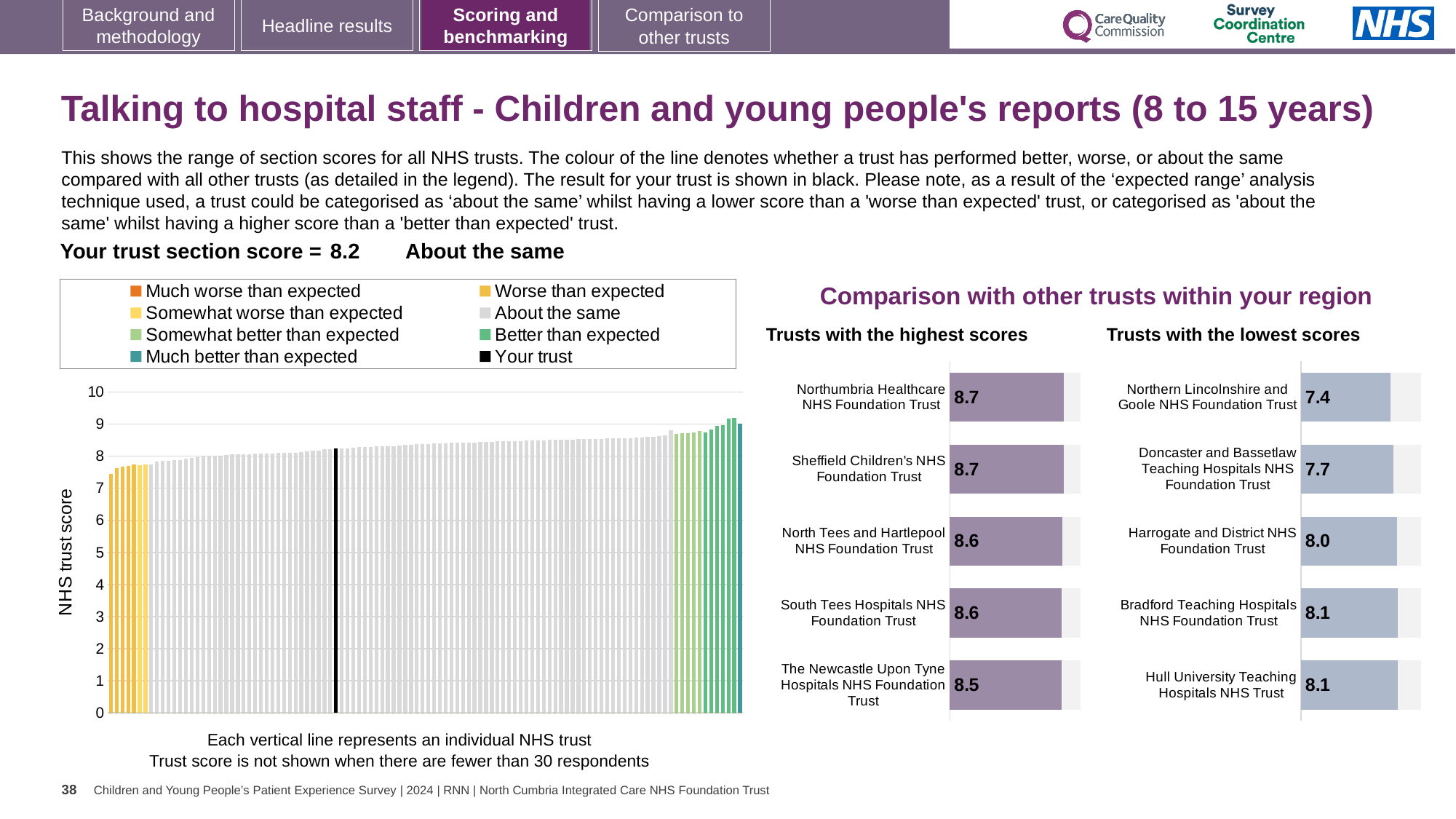
In the 'Trusts with the highest scores' chart, what is the score for North Tees and Hartlepool NHS Foundation Trust? 8.6 In the 'Trusts with the lowest scores' chart, which has the higher score: Doncaster and Bassetlaw Teaching Hospitals NHS Foundation Trust or Bradford Teaching Hospitals NHS Foundation Trust? Bradford Teaching Hospitals NHS Foundation Trust In the 'Trusts with the highest scores' chart, what is the difference between the scores of Northumbria Healthcare NHS Foundation Trust and The Newcastle Upon Tyne Hospitals NHS Foundation Trust? 0.2 In the 'Trusts with the lowest scores' chart, which trust has the lowest score? Northern Lincolnshire and Goole NHS Foundation Trust What kind of chart is the large chart on the left of the slide? Bar chart How many entries does the legend of the large chart on the left list? 8 How many trusts are listed in the 'Trusts with the highest scores' chart? 5 In the 'Trusts with the lowest scores' chart, what is the score for Doncaster and Bassetlaw Teaching Hospitals NHS Foundation Trust? 7.7 In the 'Trusts with the lowest scores' chart, what is the difference between the scores of Harrogate and District NHS Foundation Trust and Northern Lincolnshire and Goole NHS Foundation Trust? 0.6 In the large chart on the left, is the value for the lowest-scoring trust greater or less than 7? greater In the large chart on the left, is the value for the highest-scoring trust greater or less than 10? less In the 'Trusts with the highest scores' chart, which trust has the lowest score shown? The Newcastle Upon Tyne Hospitals NHS Foundation Trust